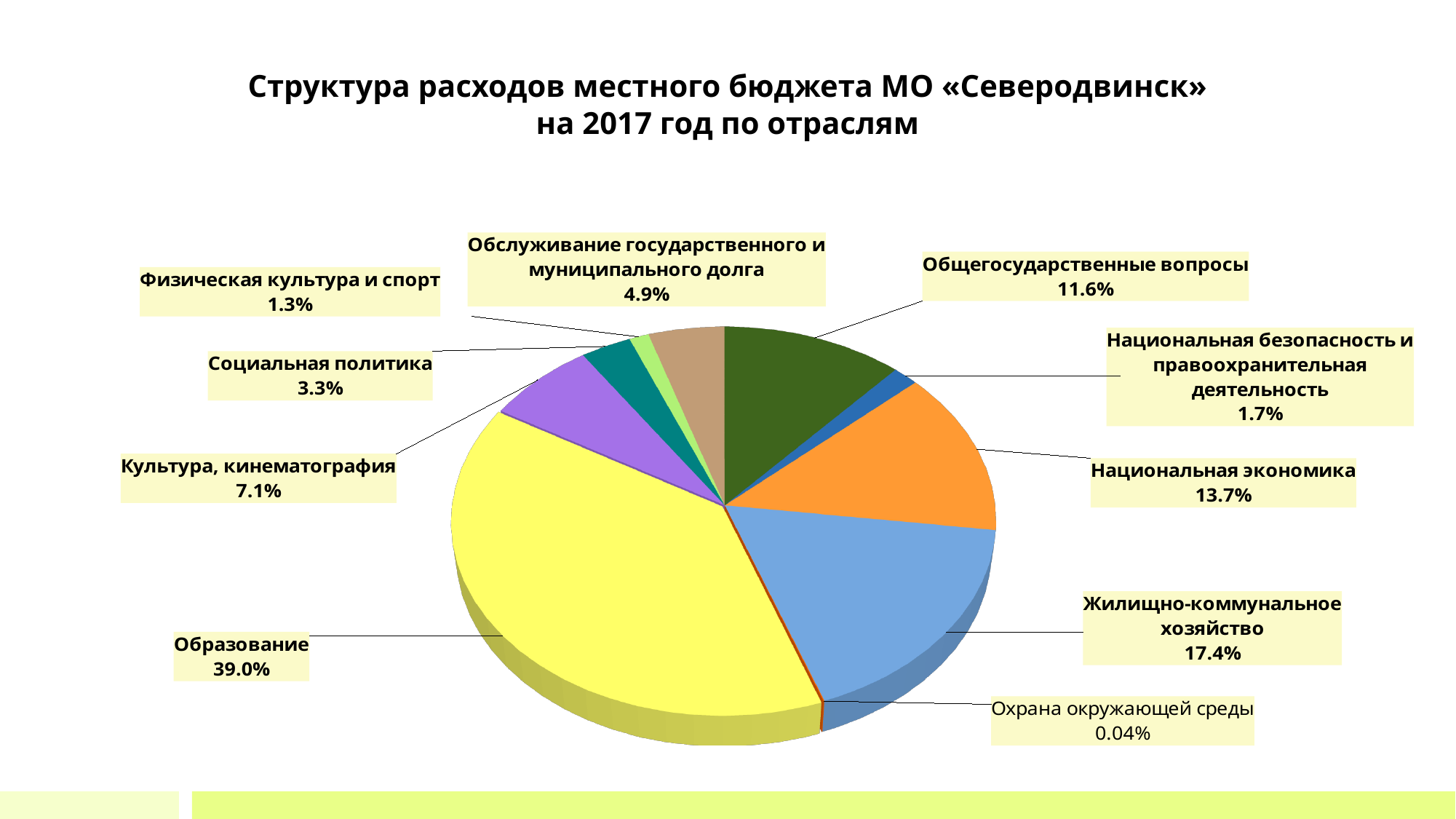
What share of the budget expenditure goes to Образование? 39.0% What is the combined share of Социальная политика and Физическая культура и спорт? 4.6% What is the title of the chart? Структура расходов местного бюджета МО «Северодвинск» на 2017 год по отраслям What share is shown for Жилищно-коммунальное хозяйство? 17.4% What type of chart is shown on the slide? Pie chart Which category has the smallest share of the pie? Охрана окружающей среды What share is shown for Охрана окружающей среды? 0.04% What is the difference in percentage points between Образование and Жилищно-коммунальное хозяйство? 21.6 Which category has the largest share of the pie? Образование Which is larger: the share for Общегосударственные вопросы or for Национальная экономика? Национальная экономика What percentage is labelled for Национальная экономика? 13.7% How many categories are shown in the pie chart? 10